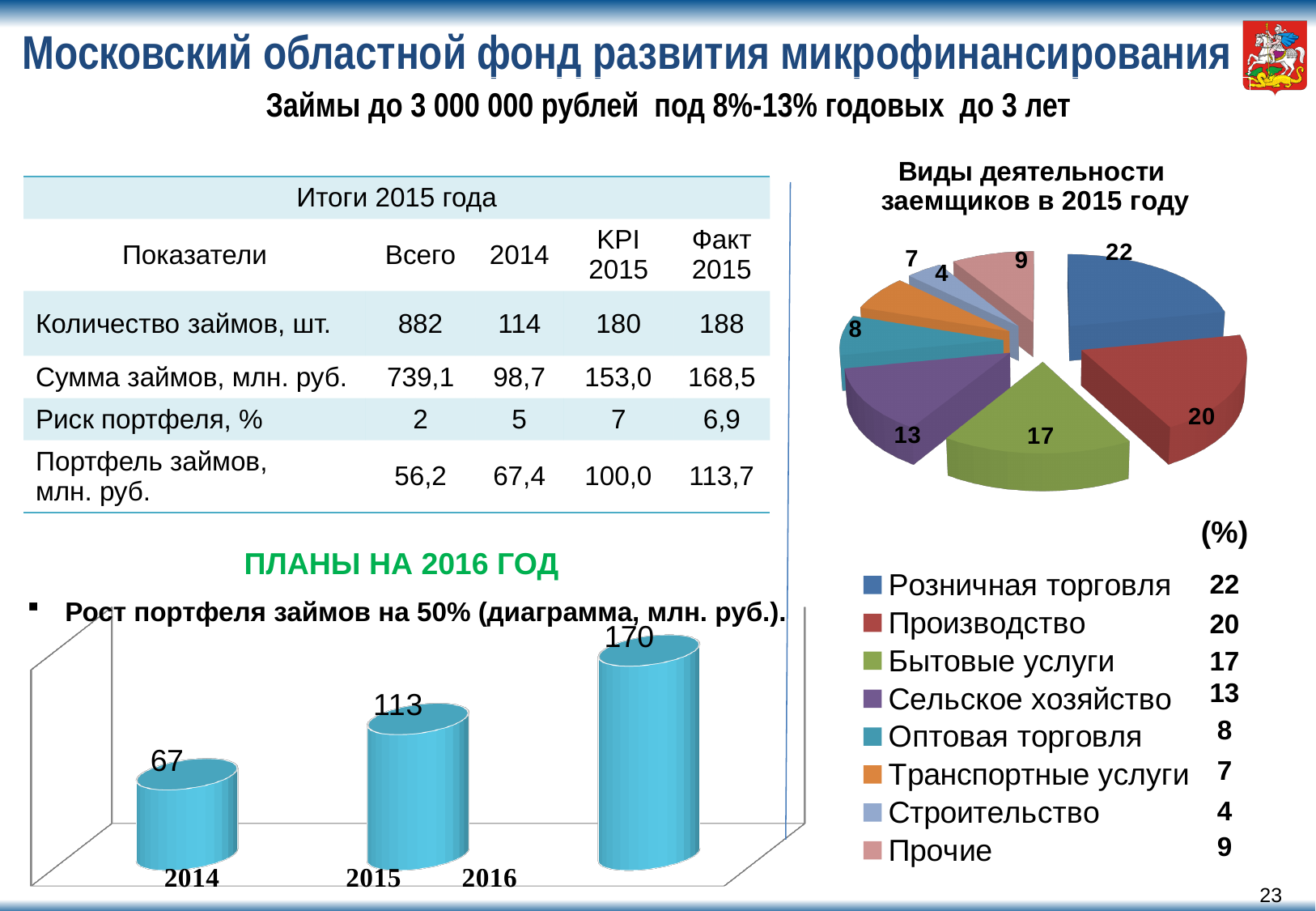
In the bar chart under 'ПЛАНЫ НА 2016 ГОД', what is the value for 2016? 170 In the pie chart 'Виды деятельности заемщиков в 2015 году', what is the difference between Производство and Бытовые услуги? 3 In the pie chart 'Виды деятельности заемщиков в 2015 году', which category has the largest share? Розничная торговля In the pie chart 'Виды деятельности заемщиков в 2015 году', what is the value for Розничная торговля? 22 What kind of chart is shown under 'ПЛАНЫ НА 2016 ГОД'? Bar chart How many categories does the legend of the pie chart 'Виды деятельности заемщиков в 2015 году' list? 8 In the bar chart under 'ПЛАНЫ НА 2016 ГОД', do the values rise or fall from 2014 to 2016? Rise In the bar chart under 'ПЛАНЫ НА 2016 ГОД', what is the difference between the 2016 and 2015 values? 57 In the pie chart 'Виды деятельности заемщиков в 2015 году', what is the value for Сельское хозяйство? 13 In the pie chart 'Виды деятельности заемщиков в 2015 году', which is larger: Оптовая торговля or Прочие? Прочие In the pie chart 'Виды деятельности заемщиков в 2015 году', which category has the smallest share? Строительство What kind of chart is 'Виды деятельности заемщиков в 2015 году'? Pie chart